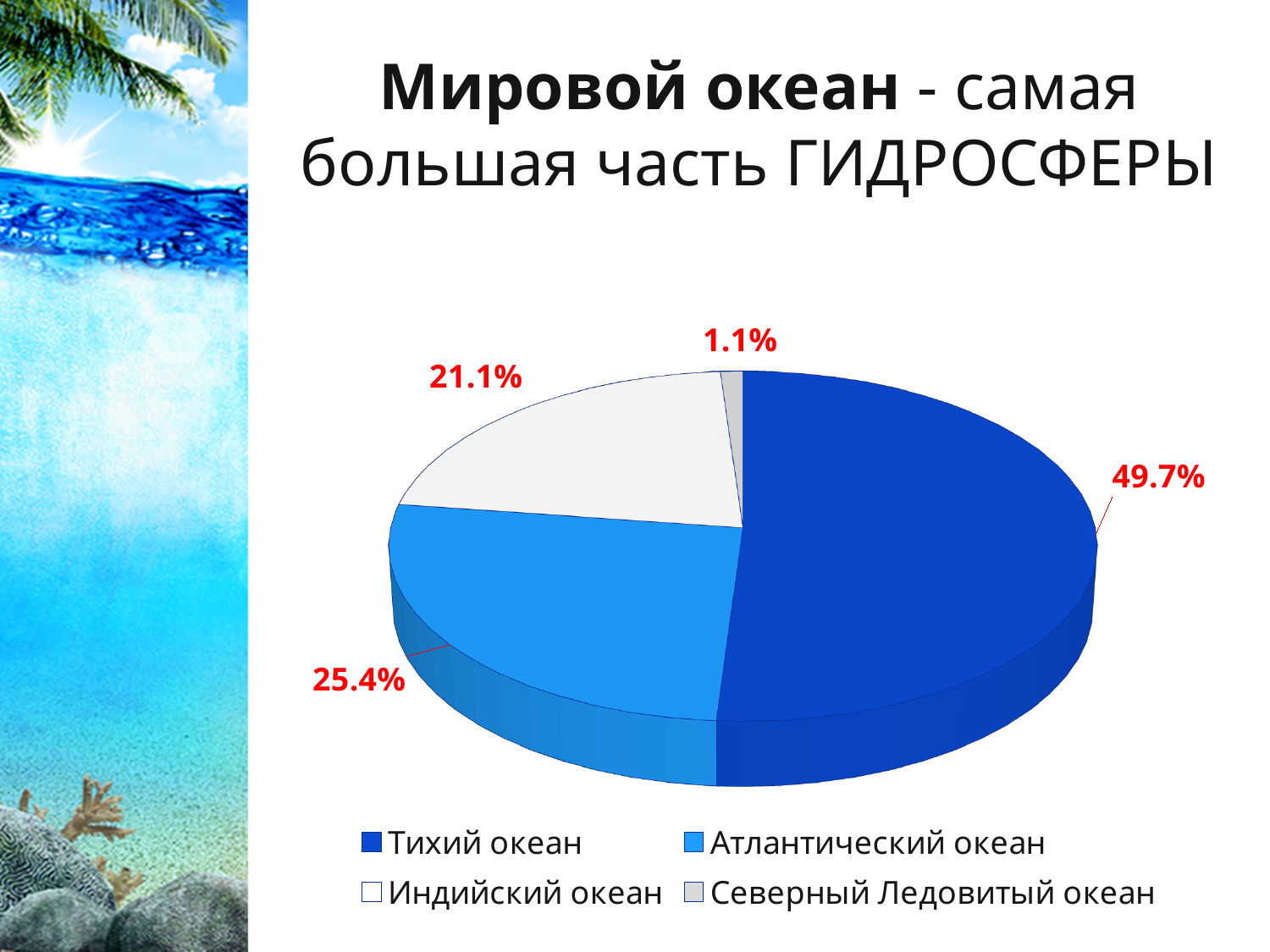
What percentage is shown for Северный Ледовитый океан? 1.1% Which ocean has the smallest share of the pie? Северный Ледовитый океан What percentage is shown for Тихий океан? 49.7% Which is larger, the share for Атлантический океан or the share for Индийский океан? Атлантический океан What percentage is shown for Атлантический океан? 25.4% What is the difference in percentage points between Тихий океан and Атлантический океан? 24.3 How many entries does the legend list? 4 How many slices does the pie chart have? 4 What colour is the slice for Тихий океан? Dark blue Which ocean has the largest share of the pie? Тихий океан What type of chart is shown on the slide? Pie chart What percentage is shown for Индийский океан? 21.1%